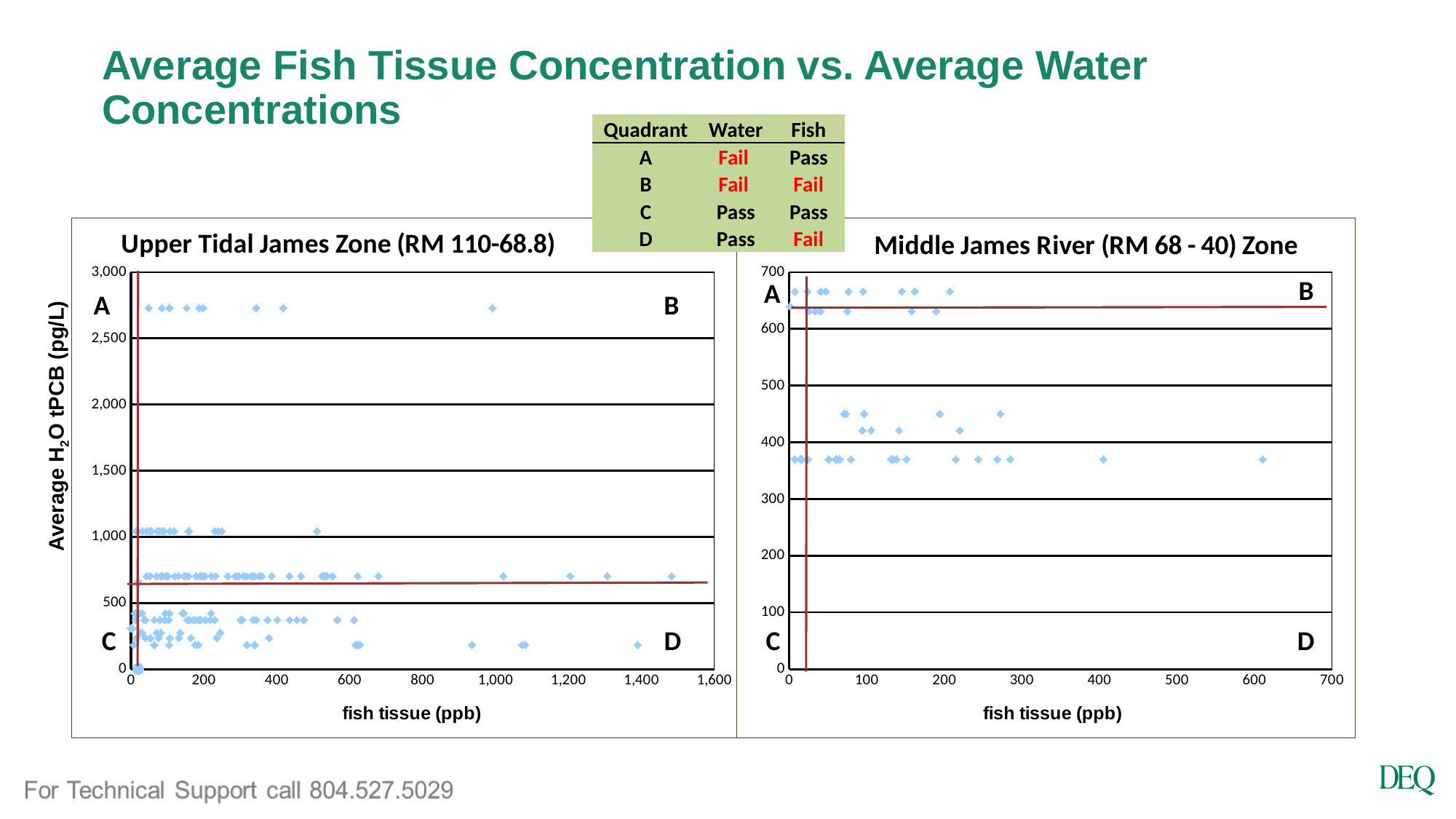
In the Middle James River (RM 68 - 40) Zone chart, is the highest plotted water concentration greater or less than 600? greater In the Upper Tidal James Zone (RM 110-68.8) chart, is the highest plotted water concentration greater or less than 2,500? greater In the Middle James River (RM 68 - 40) Zone chart, is the lowest plotted water concentration greater or less than 300? greater What is the x-axis label of the Upper Tidal James Zone (RM 110-68.8) chart? fish tissue (ppb) What kind of chart is the Upper Tidal James Zone (RM 110-68.8) chart? scatter chart What is the title of the chart on the right side of the slide? Middle James River (RM 68 - 40) Zone How many charts are shown on the slide? 2